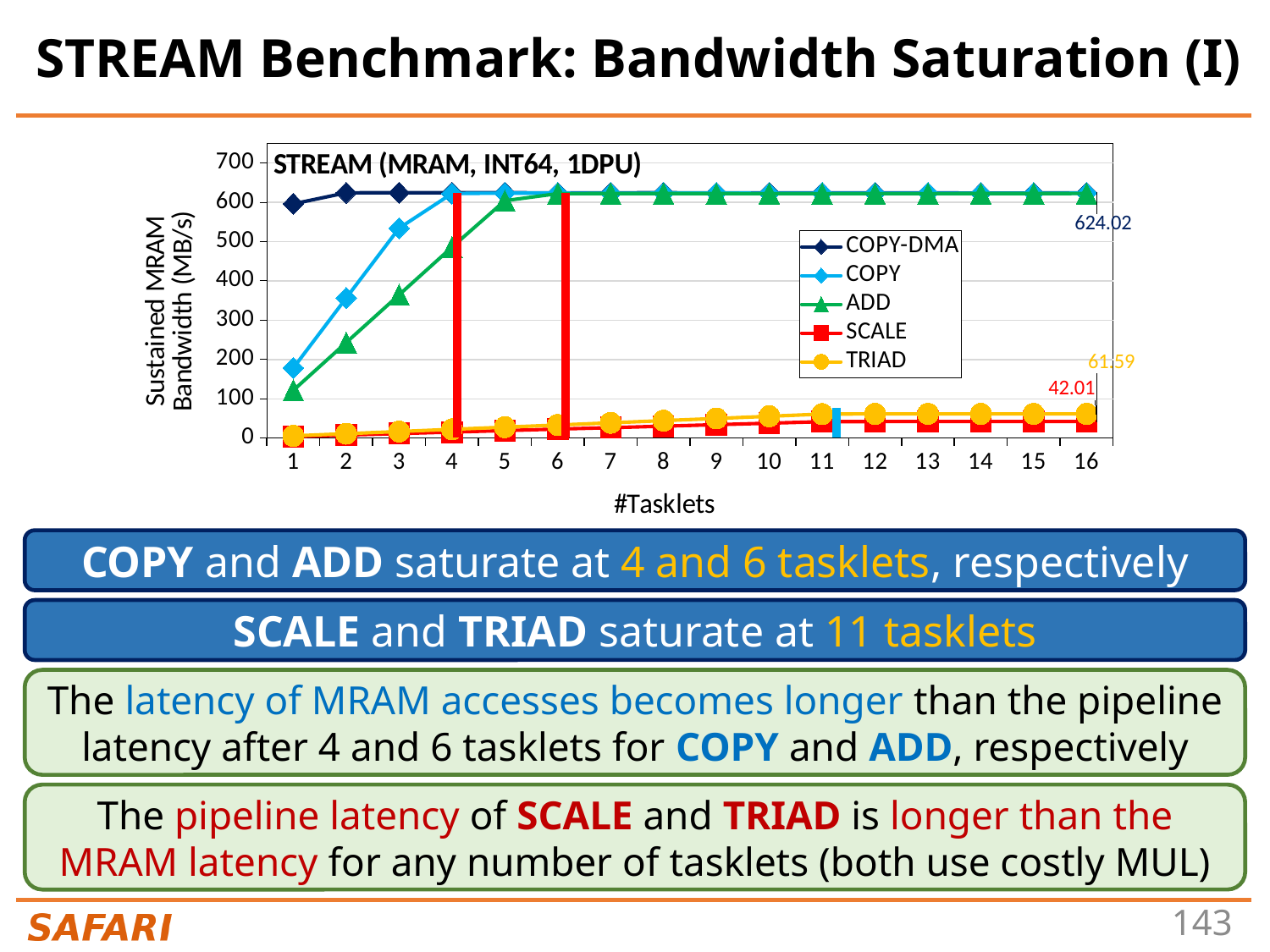
Does the ADD bandwidth rise or fall as the number of tasklets increases from 1 to 6? rise What is the difference between the TRIAD and SCALE bandwidth values labeled at 16 tasklets? 19.58 Is the bandwidth of ADD at 5 tasklets greater or less than 500? greater Is the bandwidth of ADD at 1 tasklet greater or less than 200? less What kind of chart is shown on the slide? line chart What is the sustained MRAM bandwidth of COPY-DMA at 16 tasklets? 624.02 How many tasklet counts are plotted along the x axis? 16 What is the sustained MRAM bandwidth of TRIAD at 16 tasklets? 61.59 How many series does the chart legend list? 5 What is the sustained MRAM bandwidth of SCALE at 16 tasklets? 42.01 At 16 tasklets, which has the higher bandwidth, SCALE or TRIAD? TRIAD What is the title printed inside the chart area? STREAM (MRAM, INT64, 1DPU)